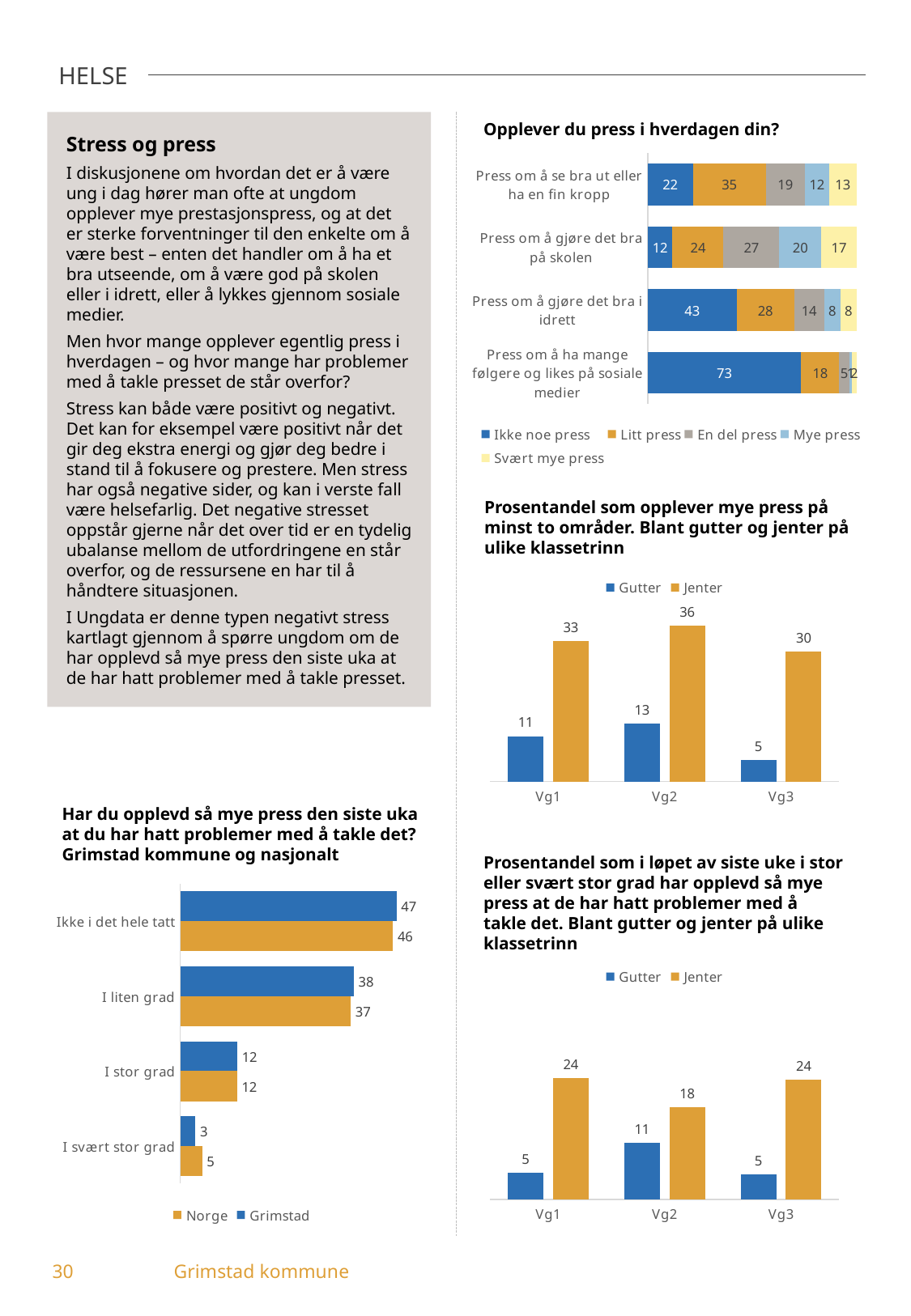
In the chart 'Prosentandel som opplever mye press på minst to områder', what is the value for Jenter at Vg2? 36 In the chart 'Prosentandel som opplever mye press på minst to områder', what is the difference between Jenter and Gutter at Vg1? 22 What kind of chart is 'Prosentandel som i løpet av siste uke i stor eller svært stor grad har opplevd så mye press'? Bar chart In the chart 'Opplever du press i hverdagen din?', what is the value for 'En del press' for 'Press om å gjøre det bra på skolen'? 27 In the chart 'Opplever du press i hverdagen din?', what is the total of the stacked bar for 'Press om å se bra ut eller ha en fin kropp'? 101 In the chart 'Har du opplevd så mye press den siste uka at du har hatt problemer med å takle det?', which is larger for 'I svært stor grad': Norge or Grimstad? Norge In the chart 'Har du opplevd så mye press den siste uka at du har hatt problemer med å takle det?', how many categories are shown? 4 In the chart 'Opplever du press i hverdagen din?', how many series does the legend list? 5 In the chart 'Prosentandel som i løpet av siste uke i stor eller svært stor grad har opplevd så mye press', what is the value for Gutter at Vg2? 11 In the chart 'Opplever du press i hverdagen din?', what is the value for 'Ikke noe press' for 'Press om å gjøre det bra i idrett'? 43 In the chart 'Prosentandel som opplever mye press på minst to områder', which class level has the lowest value for Gutter? Vg3 In the chart 'Har du opplevd så mye press den siste uka at du har hatt problemer med å takle det?', what is the value for Grimstad for 'I liten grad'? 38